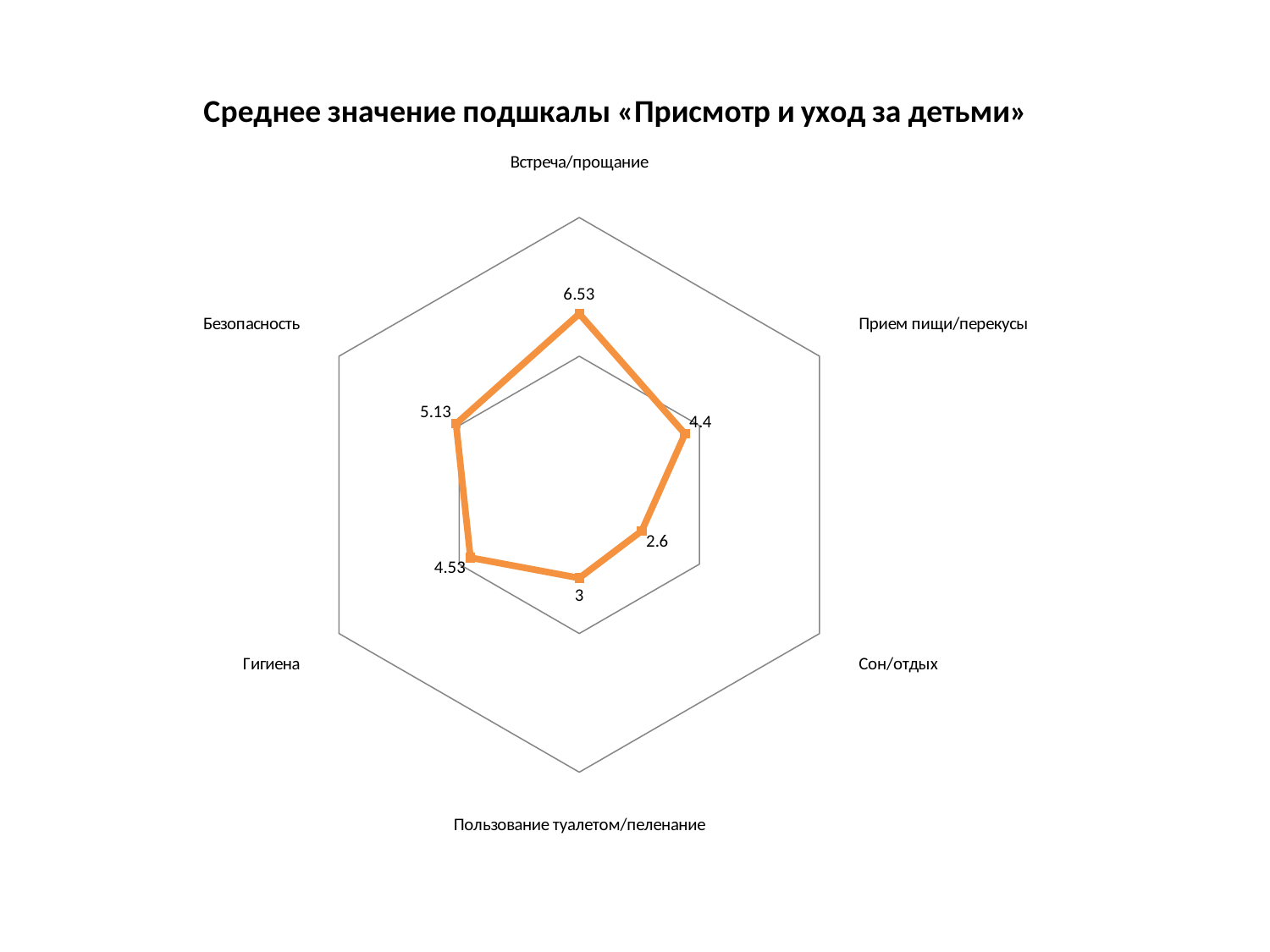
What is the difference between the values for Встреча/прощание and Сон/отдых? 3.93 Which category has the highest value? Встреча/прощание What is the value for Сон/отдых? 2.6 What is the value for Гигиена? 4.53 What is the value for Встреча/прощание? 6.53 What is the value for Безопасность? 5.13 What type of chart is shown on the slide? Radar chart Which is larger, the value for Безопасность or the value for Гигиена? Безопасность What is the value for Прием пищи/перекусы? 4.4 Which category has the lowest value? Сон/отдых How many categories are plotted on the chart? 6 What is the value for Пользование туалетом/пеленание? 3